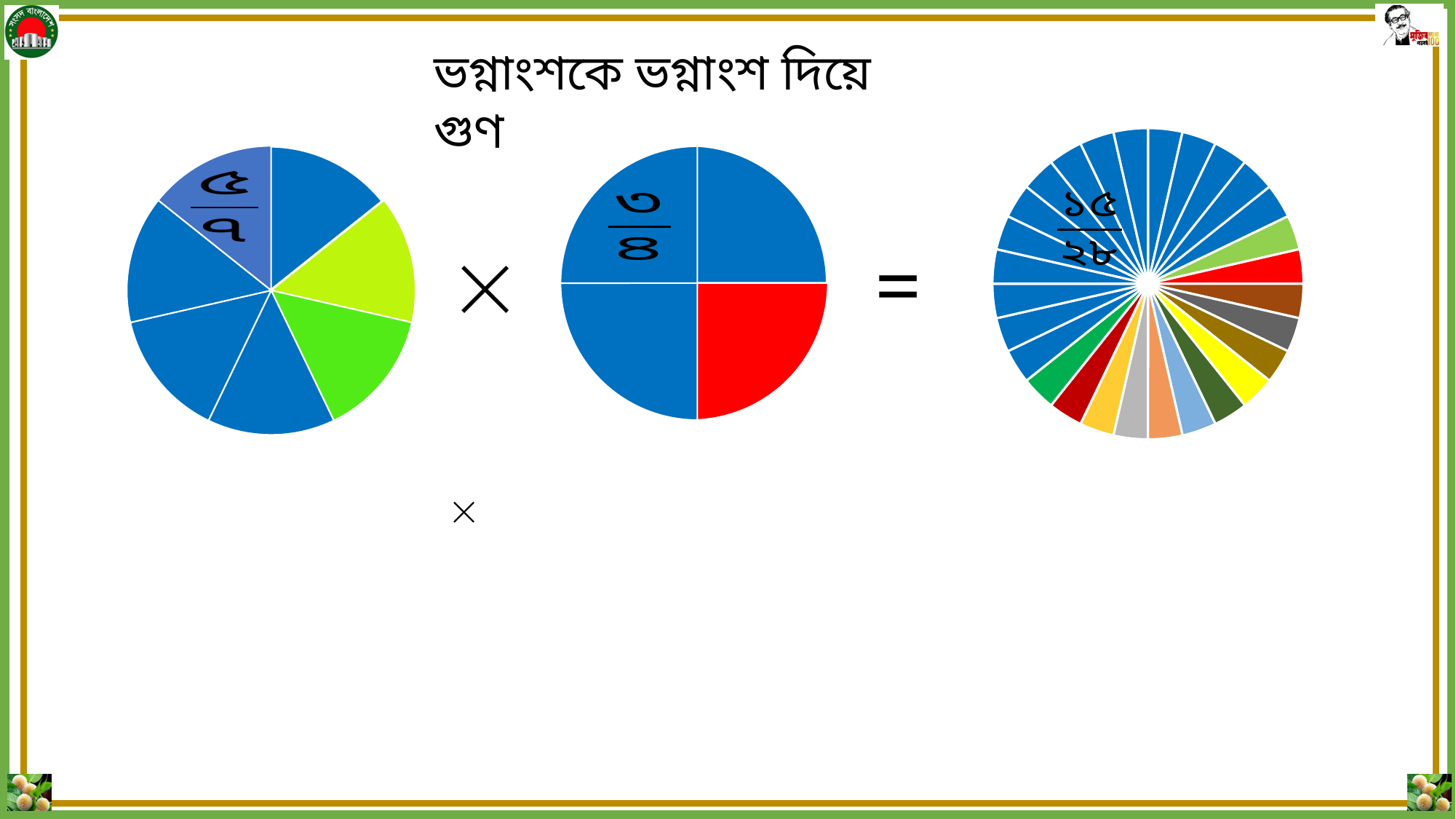
How many charts are shown on the slide? 3 In the middle pie chart, how many slices are red? 1 What kind of chart is the leftmost chart on the slide? pie chart In the middle pie chart, how many slices is the circle divided into? 4 What fraction is written on the leftmost pie chart? ৫/৭ What fraction is written on the middle pie chart? ৩/৪ What fraction is written on the rightmost pie chart? ১৫/২৮ In the middle pie chart, what share of the circle is the red slice? 1/4 What mathematical symbol is placed between the leftmost and middle pie charts? ×